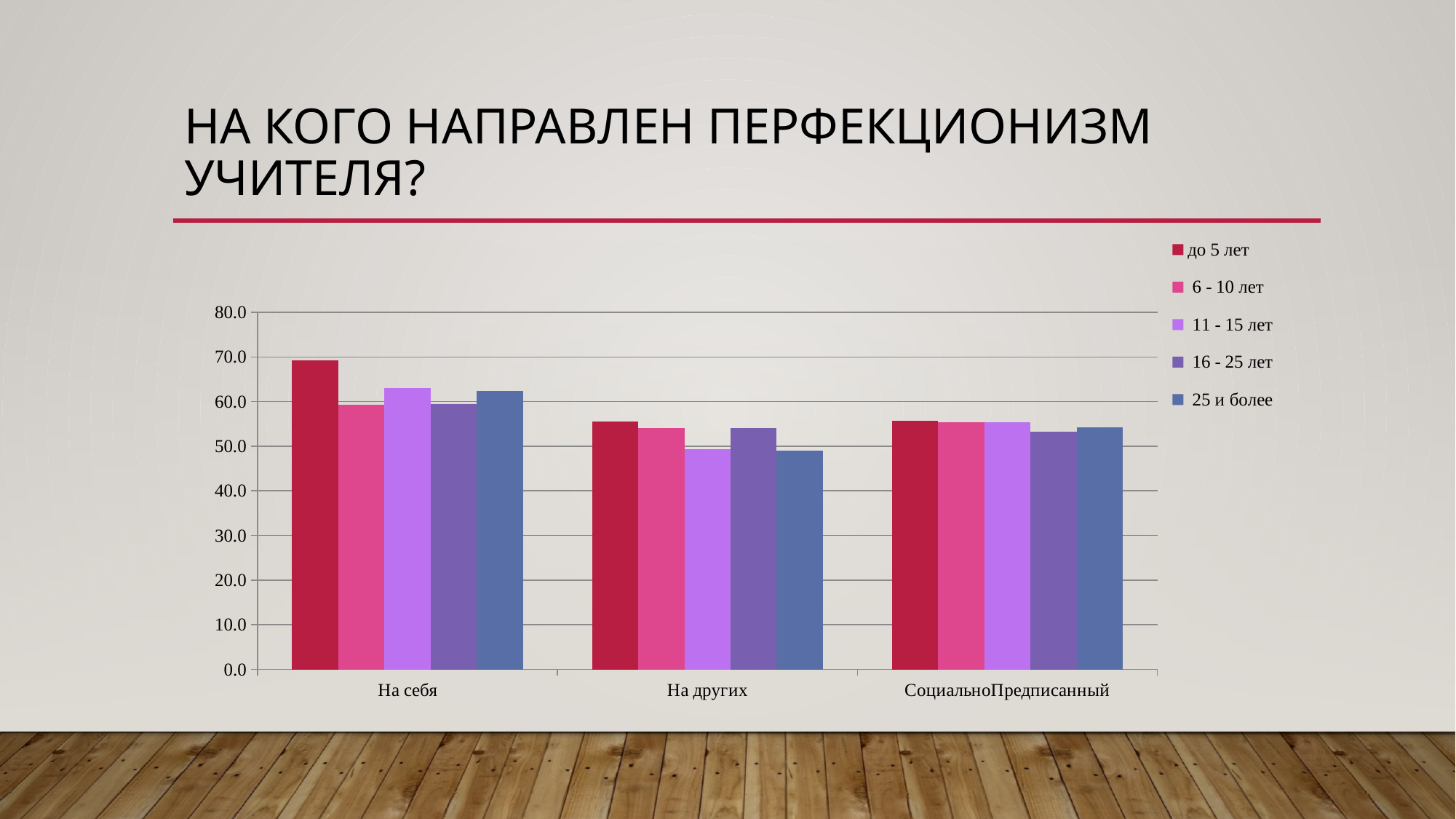
Is the value for "16 - 25 лет" in the "СоциальноПредписанный" category greater or less than 50.0? greater Is the value for "до 5 лет" in the "На себя" category greater or less than 60.0? greater How many categories are shown on the x axis of the chart? 3 Which series has the highest value in the "На себя" category? до 5 лет In the "На себя" category, which is larger: the value for "до 5 лет" or the value for "6 - 10 лет"? до 5 лет What is the label of the third category on the x axis? СоциальноПредписанный Which series is listed first in the chart legend? до 5 лет How many series does the chart legend list? 5 What kind of chart is shown on the slide? bar chart In the "На других" category, which is larger: the value for "до 5 лет" or the value for "11 - 15 лет"? до 5 лет